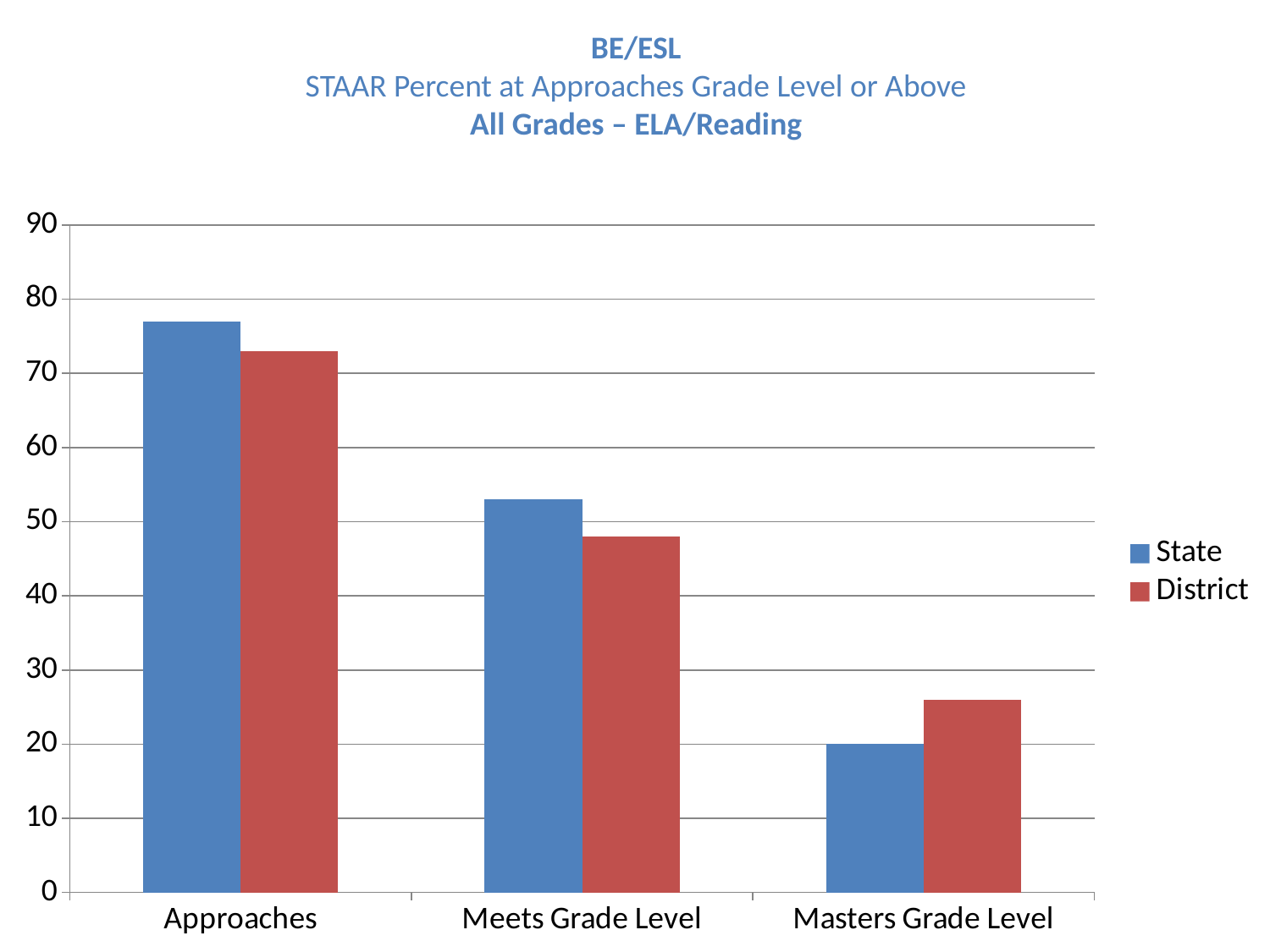
Is the District value for Meets Grade Level greater or less than 50? less Which series is shown in red? District What kind of chart is shown on the slide? bar chart For Approaches, which is larger, State or District? State Which category has the highest State value? Approaches Do the State values rise or fall from Approaches to Masters Grade Level? fall Is the State value for Meets Grade Level greater or less than 50? greater Is the District value for Masters Grade Level greater or less than 20? greater How many series does the legend list? 2 For Masters Grade Level, which is larger, State or District? District How many categories are shown on the x axis? 3